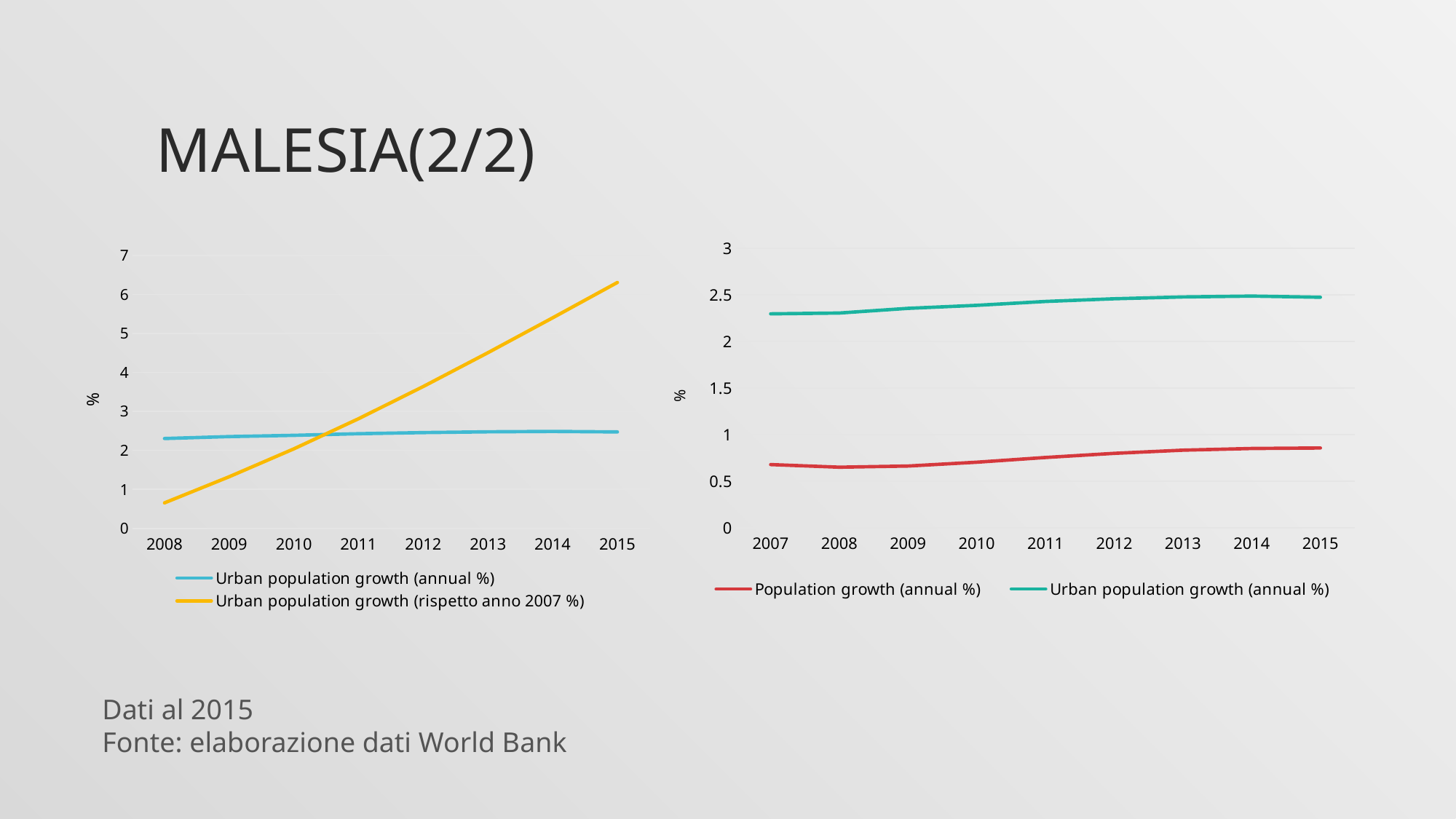
In the right chart, which series has the larger value in 2015: 'Population growth (annual %)' or 'Urban population growth (annual %)'? Urban population growth (annual %) What kind of chart is the chart on the left of the slide? line chart In the left chart, in which year is 'Urban population growth (rispetto anno 2007 %)' highest? 2015 In the left chart, is the 2015 value for 'Urban population growth (rispetto anno 2007 %)' greater or less than 6? greater In the right chart, is the 2015 value for 'Urban population growth (annual %)' greater or less than 2? greater How many years are shown on the x axis of the right chart? 9 In the left chart, does the 'Urban population growth (rispetto anno 2007 %)' line rise or fall from 2008 to 2015? rise In the left chart, in which year is 'Urban population growth (rispetto anno 2007 %)' lowest? 2008 How many series does the legend of the left chart list? 2 In the right chart, is the 2007 value for 'Population growth (annual %)' greater or less than 1? less In the left chart, which series has the larger value in 2008: 'Urban population growth (annual %)' or 'Urban population growth (rispetto anno 2007 %)'? Urban population growth (annual %) How many years are shown on the x axis of the left chart? 8